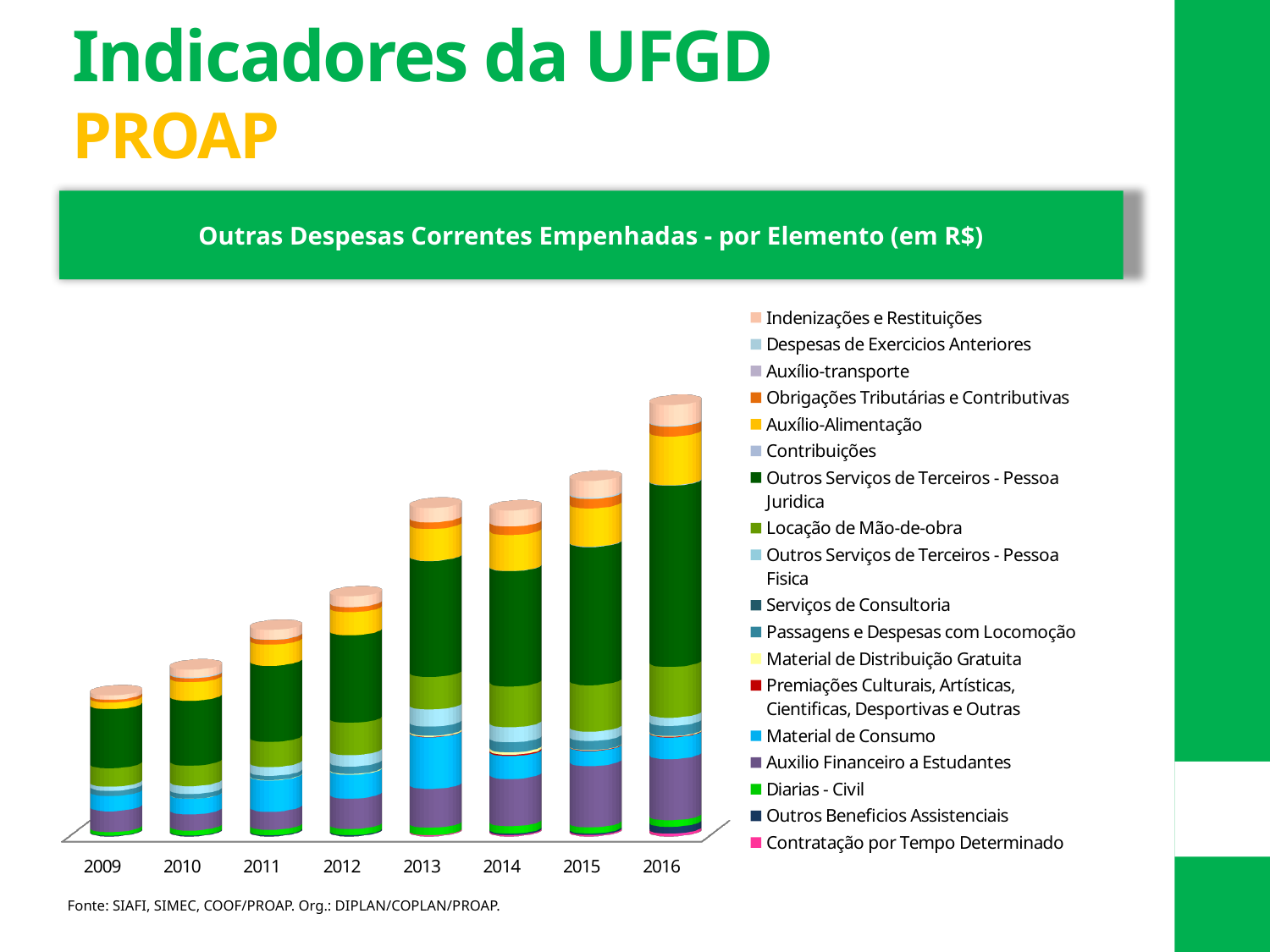
Which series occupies the largest segment of the 2016 bar? Outros Serviços de Terceiros - Pessoa Juridica Which year has the taller stacked bar, 2011 or 2012? 2012 Which year has the taller stacked bar, 2015 or 2016? 2016 Which year has the shortest stacked bar? 2009 How many years are shown along the x axis of the chart? 8 Which year has the tallest stacked bar? 2016 Which year has the taller stacked bar, 2009 or 2010? 2010 Do the total stacked bar heights generally rise or fall from 2009 to 2016? Rise What is the title of the chart? Outras Despesas Correntes Empenhadas - por Elemento (em R$) What kind of chart is shown on the slide? Stacked bar chart How many series does the chart legend list? 18 What is the first year shown on the x axis? 2009